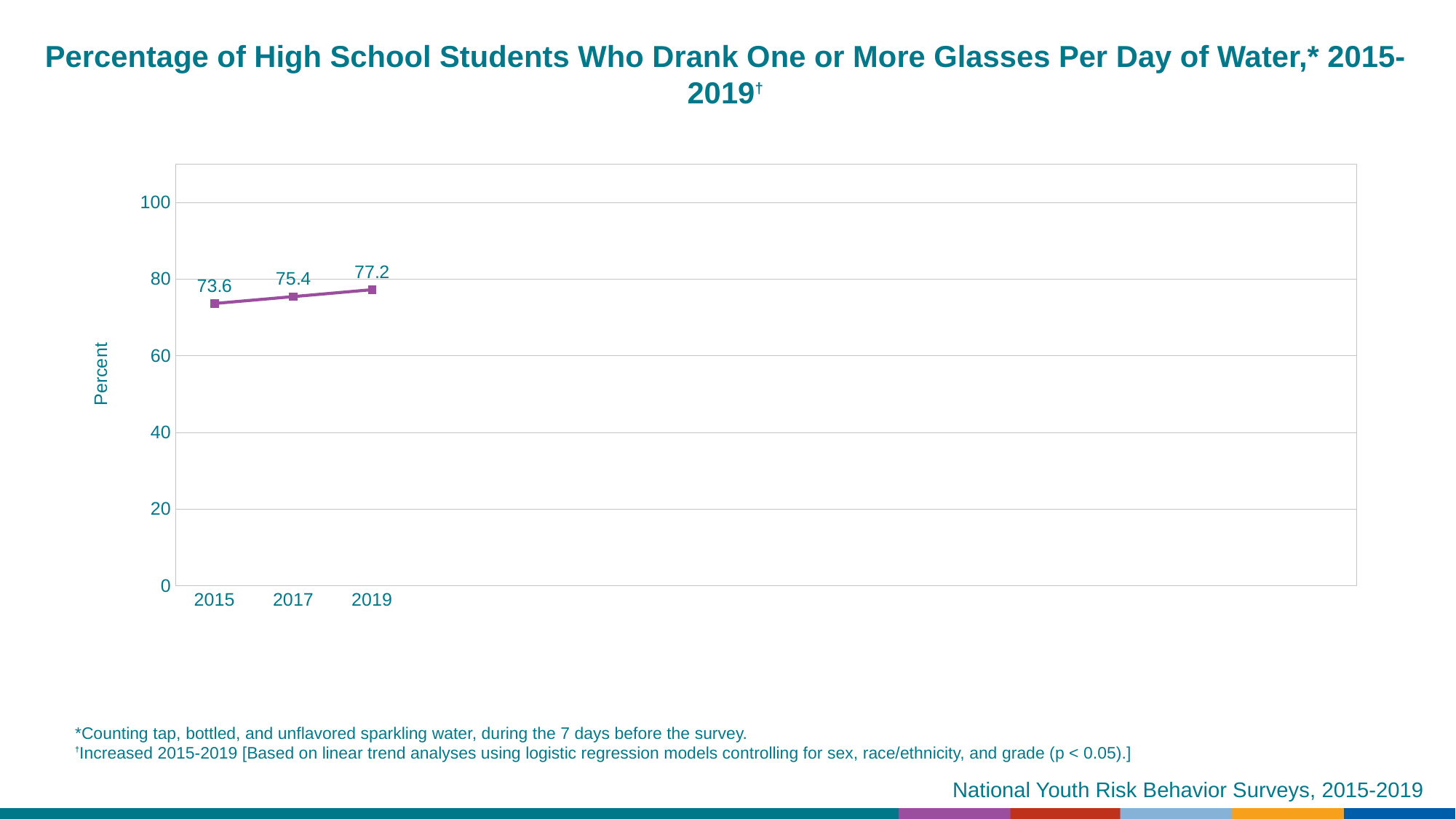
What is the difference between the 2017 value and the 2015 value? 1.8 What kind of chart is shown on the slide? line chart What percentage of high school students drank one or more glasses of water per day in 2015? 73.6 Do the values rise or fall from 2015 to 2019? rise How many years are plotted on the chart? 3 What is the value plotted for 2019? 77.2 Which year has the highest value on the chart? 2019 Is the value for 2015 greater or less than 80? less Which year has the lowest value on the chart? 2015 Which is larger, the value for 2017 or the value for 2019? 2019 What is the value plotted for 2017? 75.4 What is the difference between the 2019 value and the 2015 value? 3.6